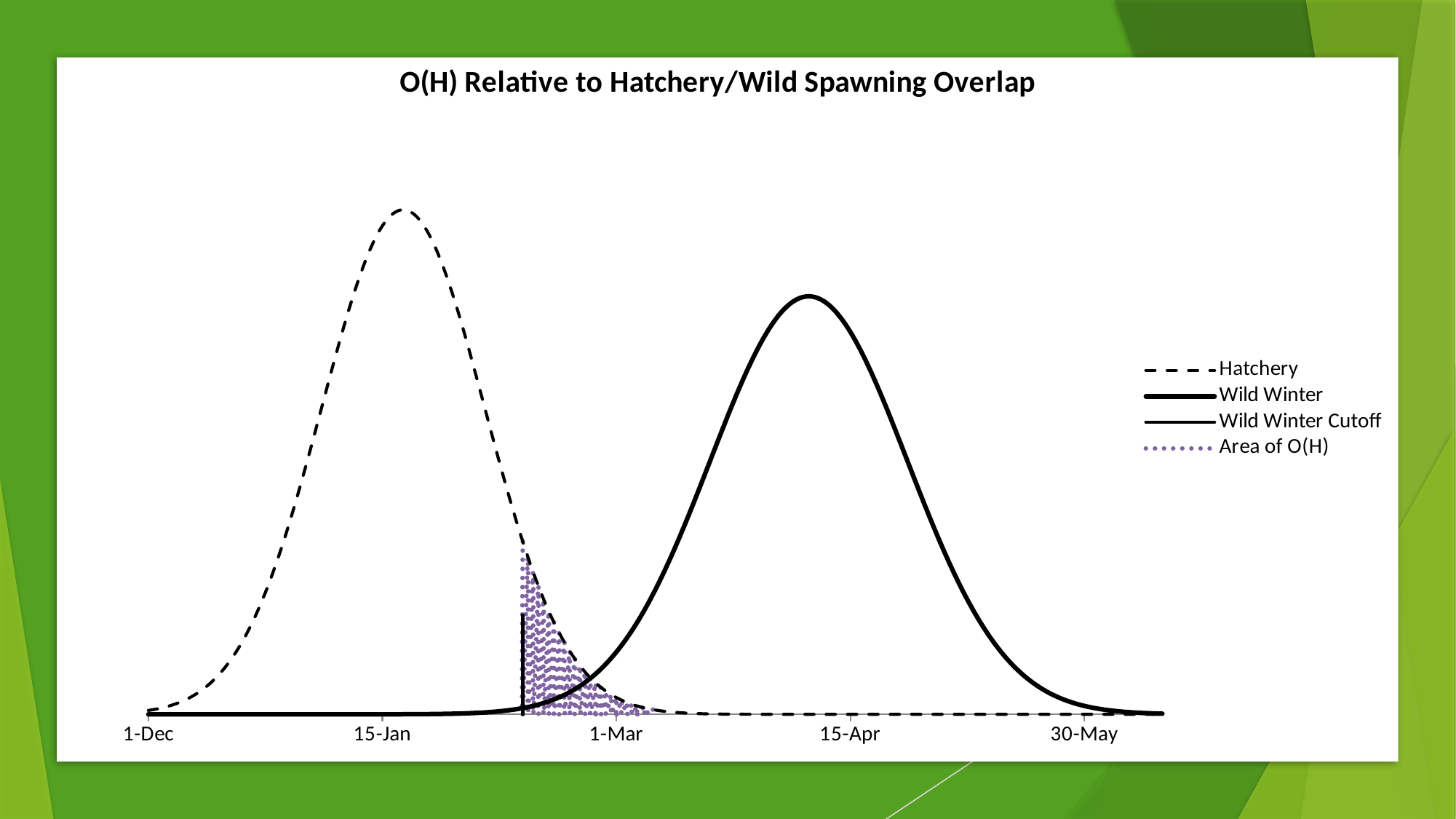
Which series peaks earlier in the year, Hatchery or Wild Winter? Hatchery Which series reaches the higher peak, Hatchery or Wild Winter? Hatchery What is the title of the chart? O(H) Relative to Hatchery/Wild Spawning Overlap Does the Wild Winter curve rise or fall between 15-Apr and 30-May? fall Which series is drawn with a dashed line? Hatchery Near which x-axis date label does the Hatchery curve reach its peak? 15-Jan What kind of chart is shown on the slide? line chart Does the Wild Winter curve rise or fall between 1-Mar and 15-Apr? rise Does the Hatchery curve rise or fall between 1-Dec and 15-Jan? rise Near which x-axis date label does the Wild Winter curve reach its peak? 15-Apr How many date labels are shown on the x axis? 5 How many series does the legend list? 4